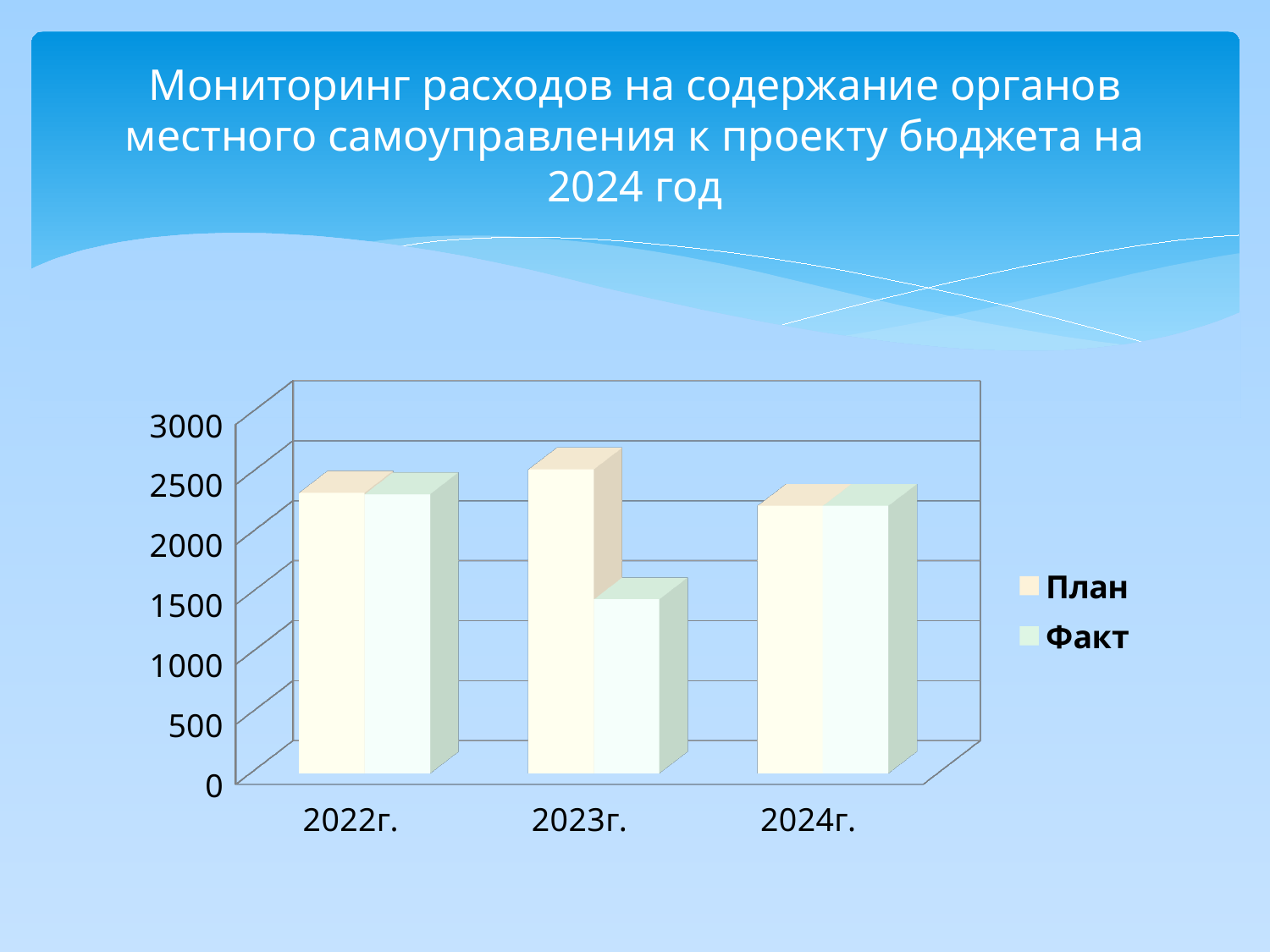
Which year has the highest План value? 2023г. Is the Факт value for 2023г. greater or less than 2000? less For 2023г., which is larger, План or Факт? План Is the План value for 2023г. greater or less than 2000? greater Is the План value for 2022г. greater or less than 2000? greater How many year categories are shown on the x axis? 3 What are the two series named in the legend? План and Факт How many series does the legend list? 2 What kind of chart is shown on the slide? bar chart Which year has the lowest Факт value? 2023г.